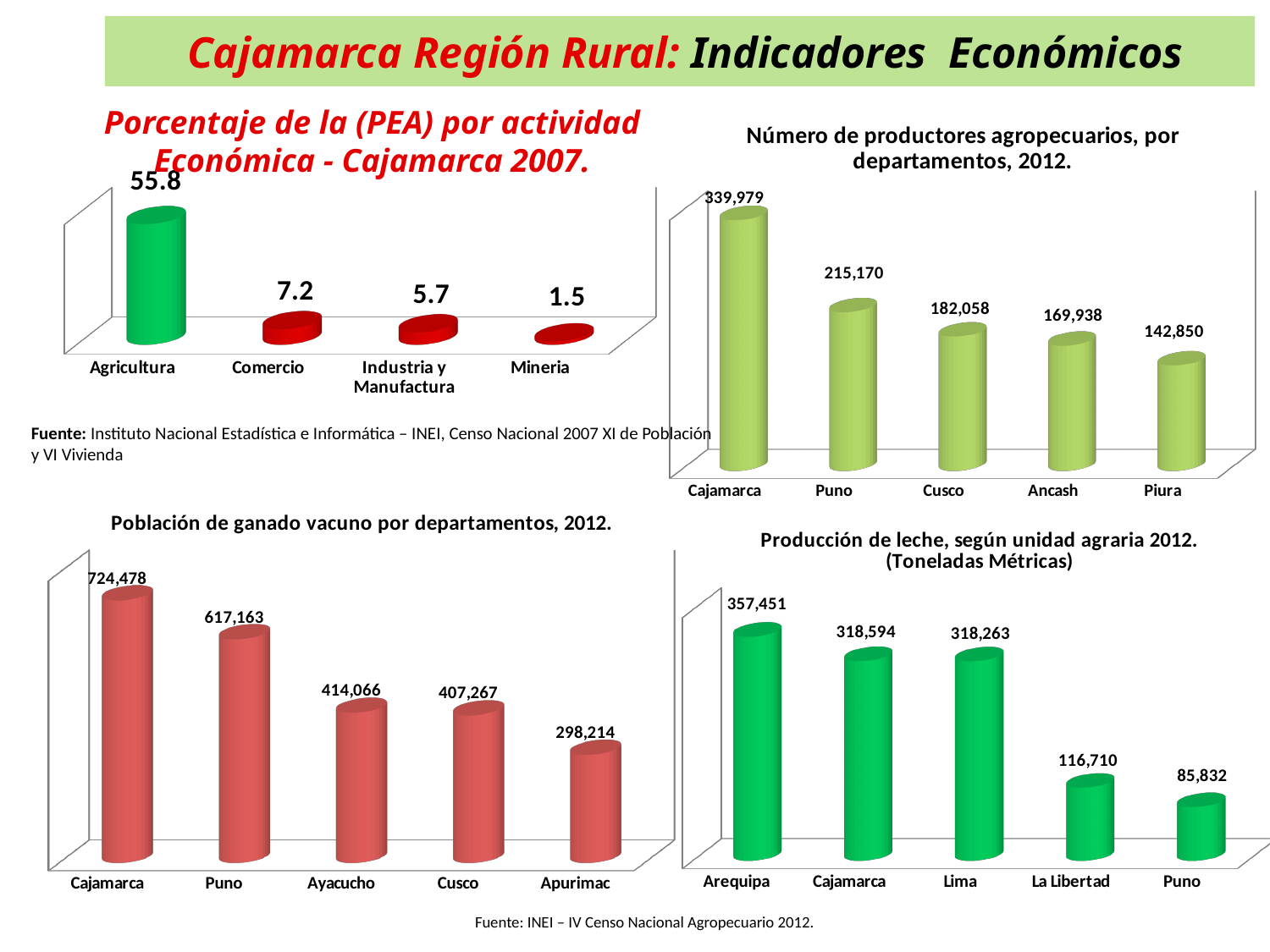
In the chart 'Porcentaje de la (PEA) por actividad Económica - Cajamarca 2007', what is the value for Agricultura? 55.8 In the chart 'Número de productores agropecuarios, por departamentos, 2012', which department has the highest value? Cajamarca In the chart 'Número de productores agropecuarios, por departamentos, 2012', what is the difference between Cajamarca and Puno? 124,809 In the chart 'Producción de leche, según unidad agraria 2012', what is the difference between Arequipa and Puno? 271,619 In the chart 'Porcentaje de la (PEA) por actividad Económica - Cajamarca 2007', what is the difference between Agricultura and Comercio? 48.6 In the chart 'Número de productores agropecuarios, por departamentos, 2012', how many departments are shown? 5 In the chart 'Producción de leche, según unidad agraria 2012', what is the value for La Libertad? 116,710 In the chart 'Porcentaje de la (PEA) por actividad Económica - Cajamarca 2007', which activity has the lowest value? Mineria In the chart 'Población de ganado vacuno por departamentos, 2012', what is the value for Apurimac? 298,214 In the chart 'Número de productores agropecuarios, por departamentos, 2012', what is the value for Cusco? 182,058 In the chart 'Población de ganado vacuno por departamentos, 2012', which is larger, Ayacucho or Cusco? Ayacucho In the chart 'Población de ganado vacuno por departamentos, 2012', do the values rise or fall from left to right? fall